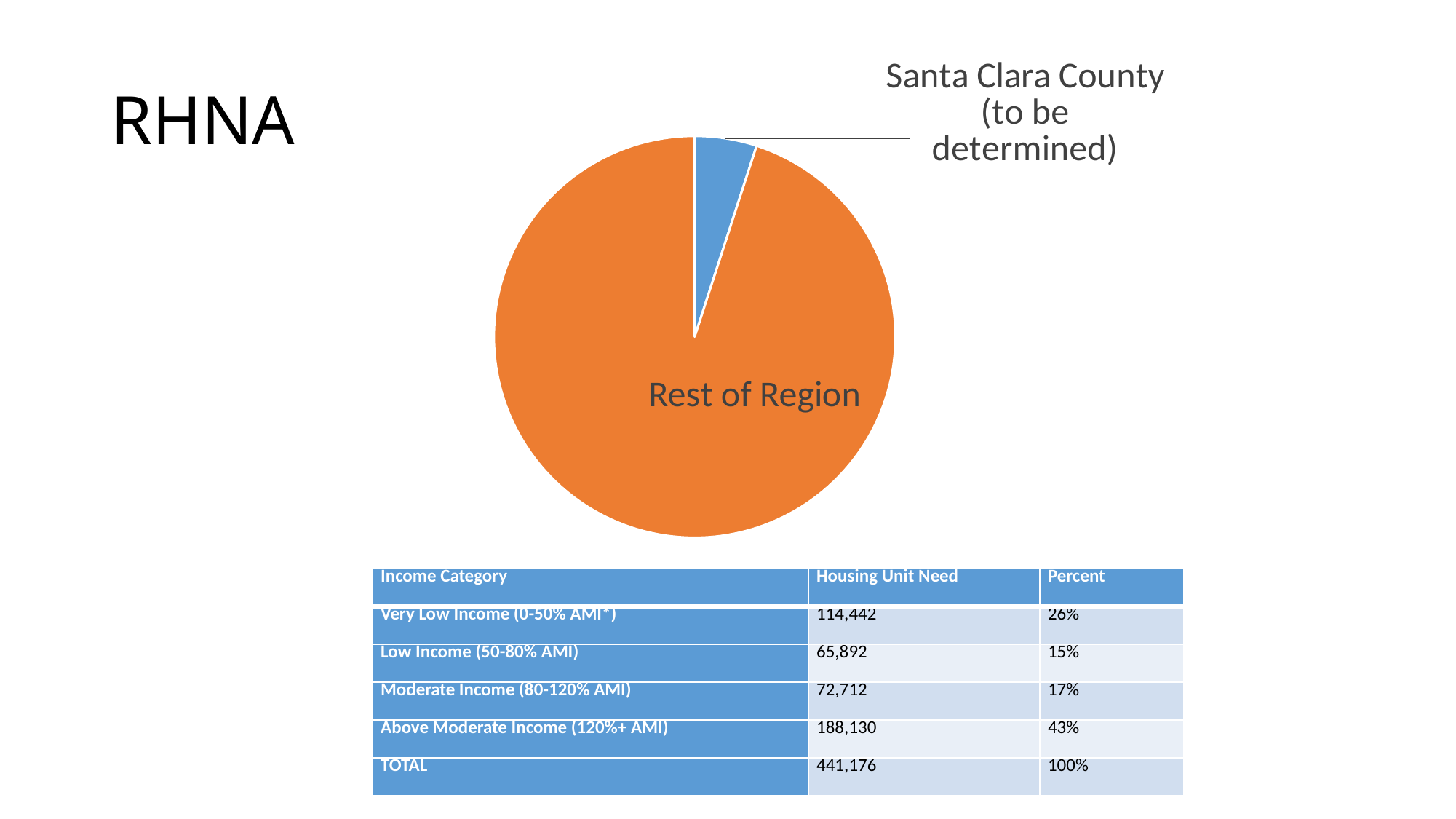
Which slice of the pie chart is the smallest? Santa Clara County (to be determined) What colour is the Santa Clara County slice in the pie chart? Blue Which slice of the pie chart is the largest? Rest of Region How many slices does the pie chart have? 2 What colour is the Rest of Region slice in the pie chart? Orange Which is larger in the pie chart, Rest of Region or Santa Clara County? Rest of Region What kind of chart is shown on the slide? Pie chart